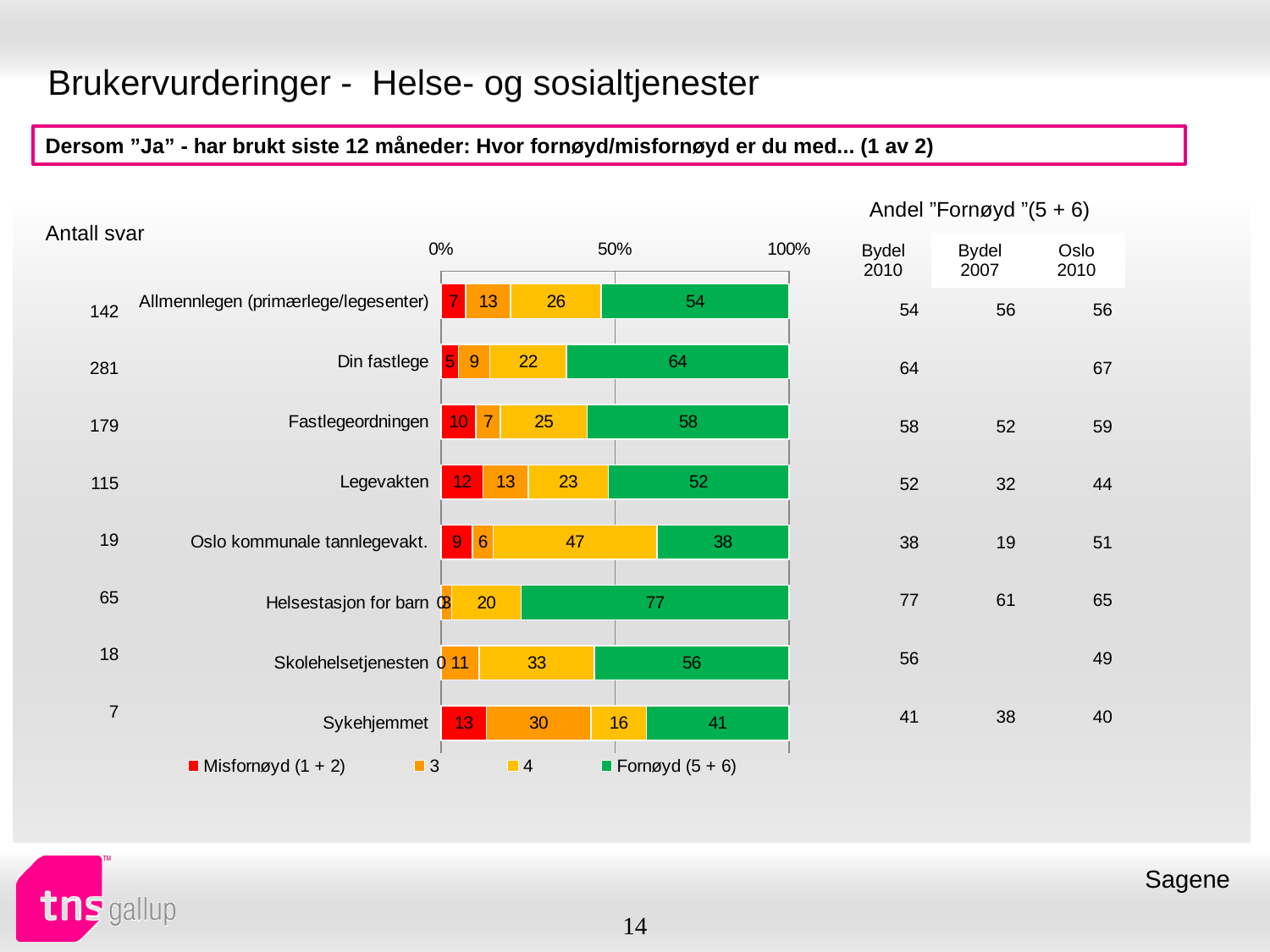
What is the difference between the Fornøyd (5 + 6) values for Din fastlege and Allmennlegen (primærlege/legesenter)? 10 Which has a larger Fornøyd (5 + 6) value, Legevakten or Fastlegeordningen? Fastlegeordningen What is the Misfornøyd (1 + 2) value for Sykehjemmet? 13 Which category has the highest Fornøyd (5 + 6) value? Helsestasjon for barn What kind of chart is shown on the slide? bar chart What is the first entry in the chart legend? Misfornøyd (1 + 2) What is the Fornøyd (5 + 6) value for Din fastlege? 64 What is the value of the '3' series for Sykehjemmet? 30 How many categories (services) are plotted in the bar chart? 8 How many series does the chart legend list? 4 Which category has the lowest Fornøyd (5 + 6) value? Oslo kommunale tannlegevakt. What is the value of the '4' series for Oslo kommunale tannlegevakt? 47